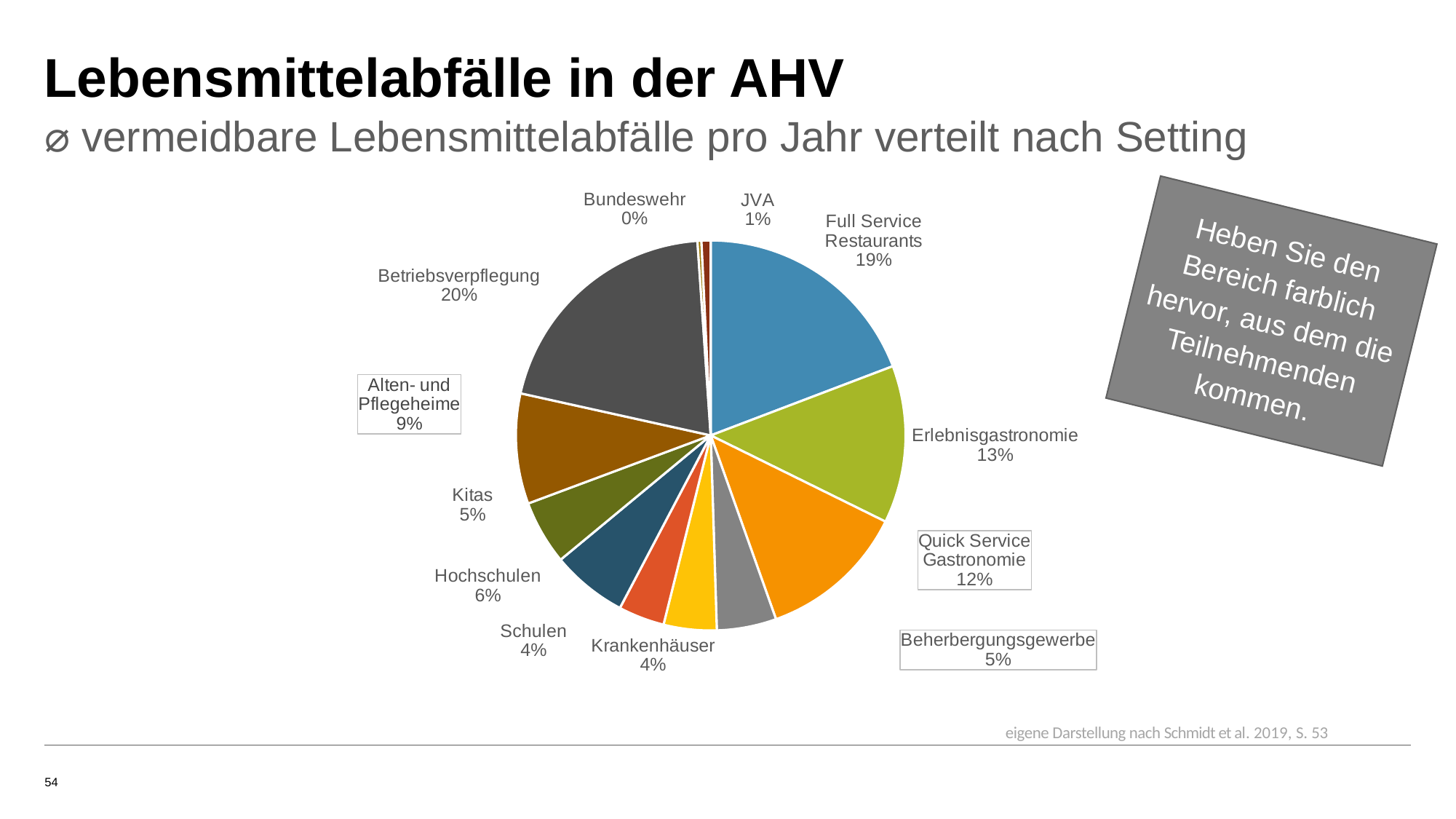
What percentage is shown for Alten- und Pflegeheime? 9% Which setting has the smallest share in the pie chart? Bundeswehr What is the difference in percentage points between Erlebnisgastronomie and Quick Service Gastronomie? 1 percentage point What percentage is shown for Betriebsverpflegung? 20% What share of avoidable food waste is attributed to Full Service Restaurants? 19% Which has a larger share, Hochschulen or Kitas? Hochschulen What kind of chart is shown on the slide? pie chart What is the combined share of Schulen and Krankenhäuser? 8% How many settings (slices) are shown in the pie chart? 12 What share does Quick Service Gastronomie have in the pie chart? 12% Which setting has the largest share in the pie chart? Betriebsverpflegung What is the subtitle of the chart on the slide? ø vermeidbare Lebensmittelabfälle pro Jahr verteilt nach Setting